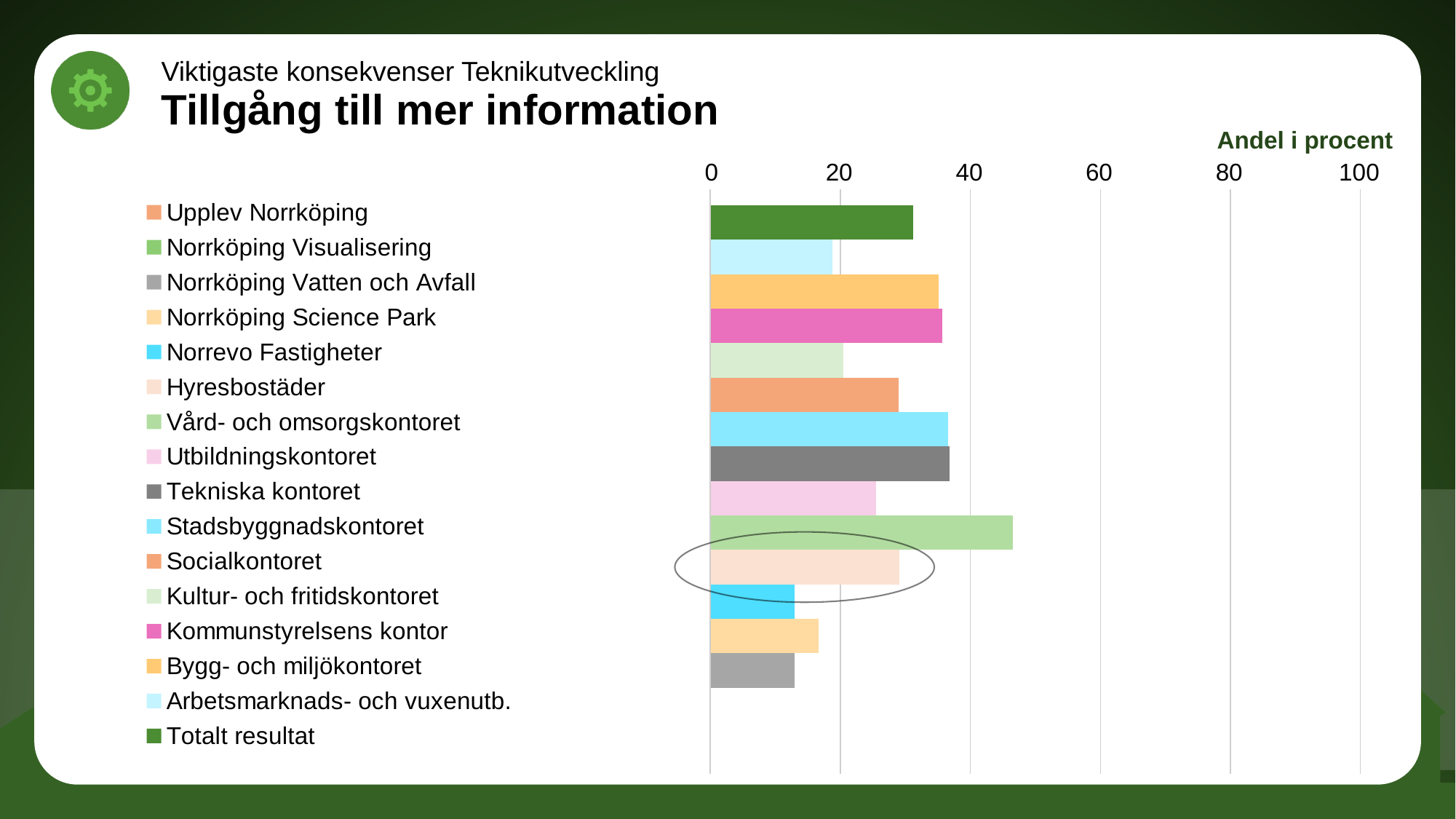
Is the value for Socialkontoret greater or less than 20? greater Which category's bar is circled on the chart? Hyresbostäder Is the value for Norrevo Fastigheter greater or less than 20? less Is the value for Vård- och omsorgskontoret greater or less than 40? greater Which category has the highest value in the chart? Vård- och omsorgskontoret Which is larger, the value for Socialkontoret or the value for Norrevo Fastigheter? Socialkontoret Which is larger, the value for Vård- och omsorgskontoret or the value for Totalt resultat? Vård- och omsorgskontoret How many entries does the legend list? 16 What is the label shown above the horizontal axis of the chart? Andel i procent What kind of chart is shown on the slide? bar chart